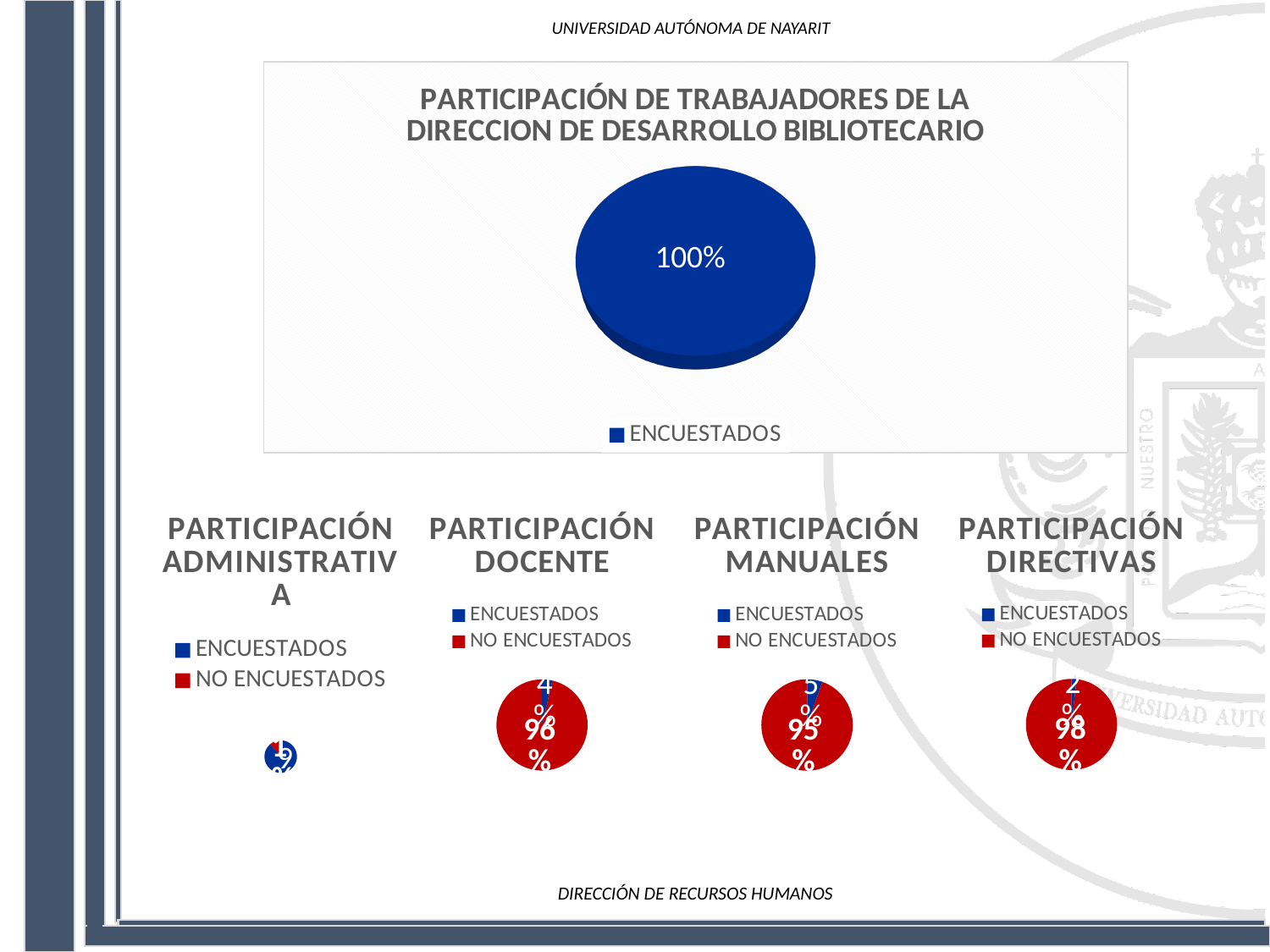
In the chart titled "PARTICIPACIÓN DIRECTIVAS", what percentage is shown for NO ENCUESTADOS? 98% In the chart titled "PARTICIPACIÓN DE TRABAJADORES DE LA DIRECCION DE DESARROLLO BIBLIOTECARIO", what percentage is shown for ENCUESTADOS? 100% How many series does the legend of the chart titled "PARTICIPACIÓN DE TRABAJADORES DE LA DIRECCION DE DESARROLLO BIBLIOTECARIO" list? 1 In the chart titled "PARTICIPACIÓN DIRECTIVAS", what percentage is shown for ENCUESTADOS? 2% What kind of chart is the large chart titled "PARTICIPACIÓN DE TRABAJADORES DE LA DIRECCION DE DESARROLLO BIBLIOTECARIO"? Pie chart In the chart titled "PARTICIPACIÓN DOCENTE", what percentage is shown for NO ENCUESTADOS? 96% In the chart titled "PARTICIPACIÓN MANUALES", what is the difference between the NO ENCUESTADOS and ENCUESTADOS percentages? 90% In the chart titled "PARTICIPACIÓN DIRECTIVAS", which slice is larger, ENCUESTADOS or NO ENCUESTADOS? NO ENCUESTADOS How many legend entries does the chart titled "PARTICIPACIÓN ADMINISTRATIVA" list? 2 In the chart titled "PARTICIPACIÓN MANUALES", what percentage is shown for ENCUESTADOS? 5% In the chart titled "PARTICIPACIÓN DOCENTE", what percentage is shown for ENCUESTADOS? 4% In the chart titled "PARTICIPACIÓN MANUALES", what percentage is shown for NO ENCUESTADOS? 95%